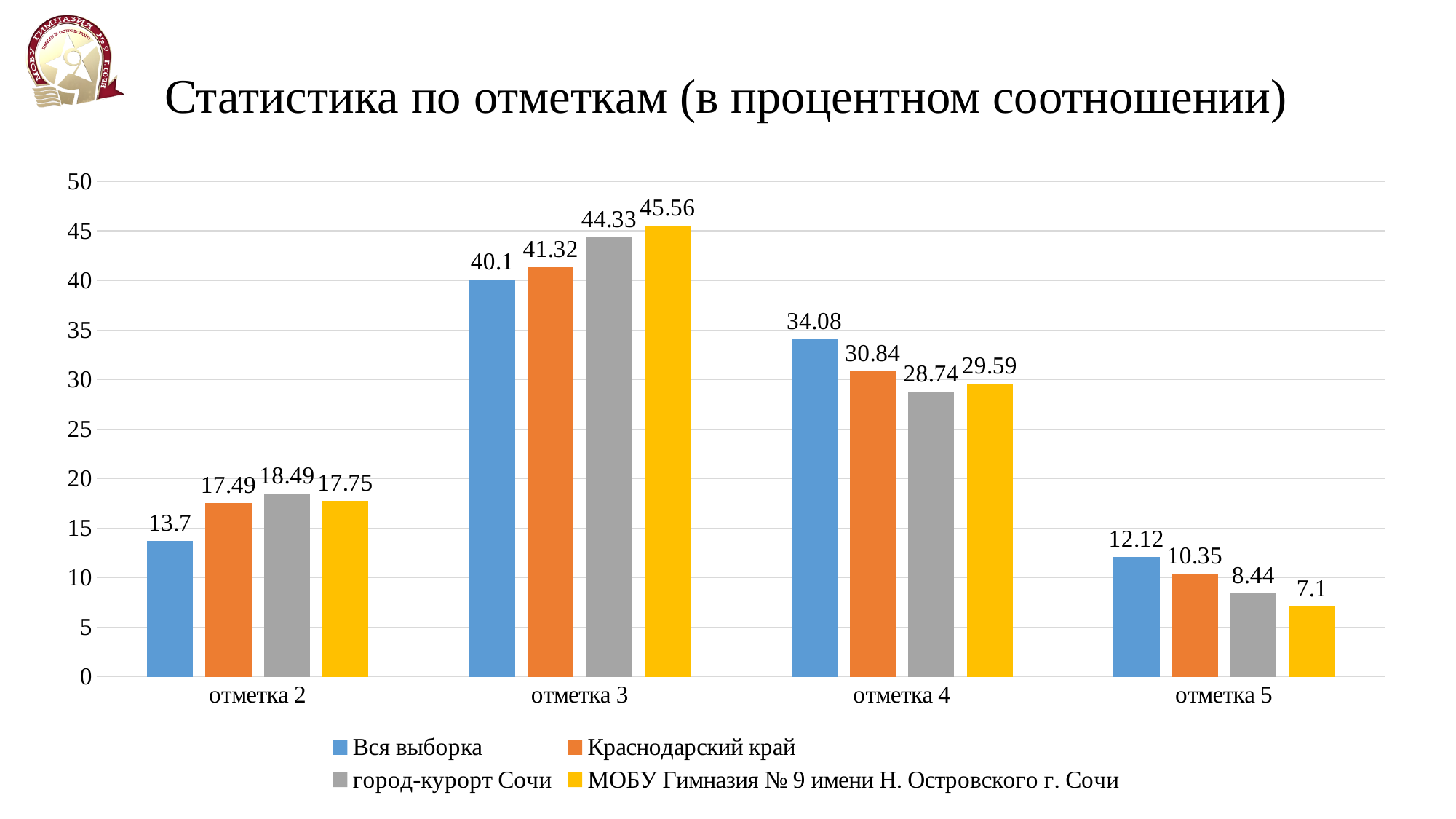
Which series has the highest value at отметка 3? МОБУ Гимназия № 9 имени Н. Островского г. Сочи What is the title of the chart? Статистика по отметкам (в процентном соотношении) How many categories are shown on the x axis? 4 What kind of chart is shown on the slide? Bar chart What is the value for МОБУ Гимназия № 9 имени Н. Островского г. Сочи at отметка 5? 7.1 Which series has the lowest value at отметка 4? город-курорт Сочи What is the value for Вся выборка at отметка 3? 40.1 How many series does the legend list? 4 What is the difference between the Вся выборка and Краснодарский край values at отметка 4? 3.24 What colour are the bars for Краснодарский край? Orange What is the value for город-курорт Сочи at отметка 2? 18.49 Which is larger at отметка 5: Вся выборка or Краснодарский край? Вся выборка